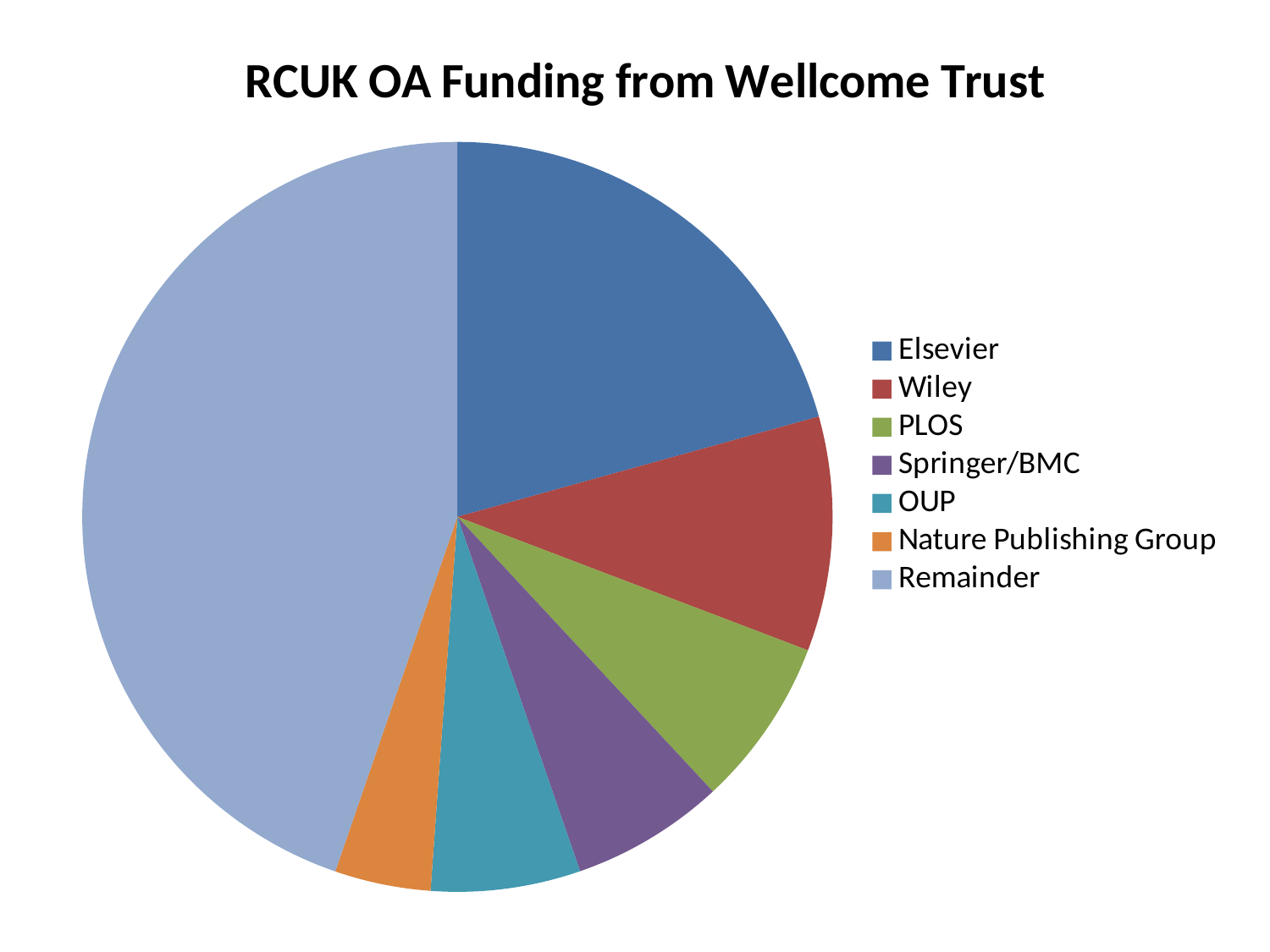
Which slice is larger, Wiley or PLOS? Wiley Which slice is larger, Elsevier or Wiley? Elsevier Which legend entry is listed last? Remainder Which category has the smallest slice of the pie? Nature Publishing Group How many entries does the legend list? 7 What is the title of the chart? RCUK OA Funding from Wellcome Trust What kind of chart is shown on the slide? Pie chart Which of the named publishers (excluding Remainder) has the largest slice? Elsevier How many slices does the pie chart have? 7 Which slice is larger, Elsevier or PLOS? Elsevier Which category has the largest slice of the pie? Remainder